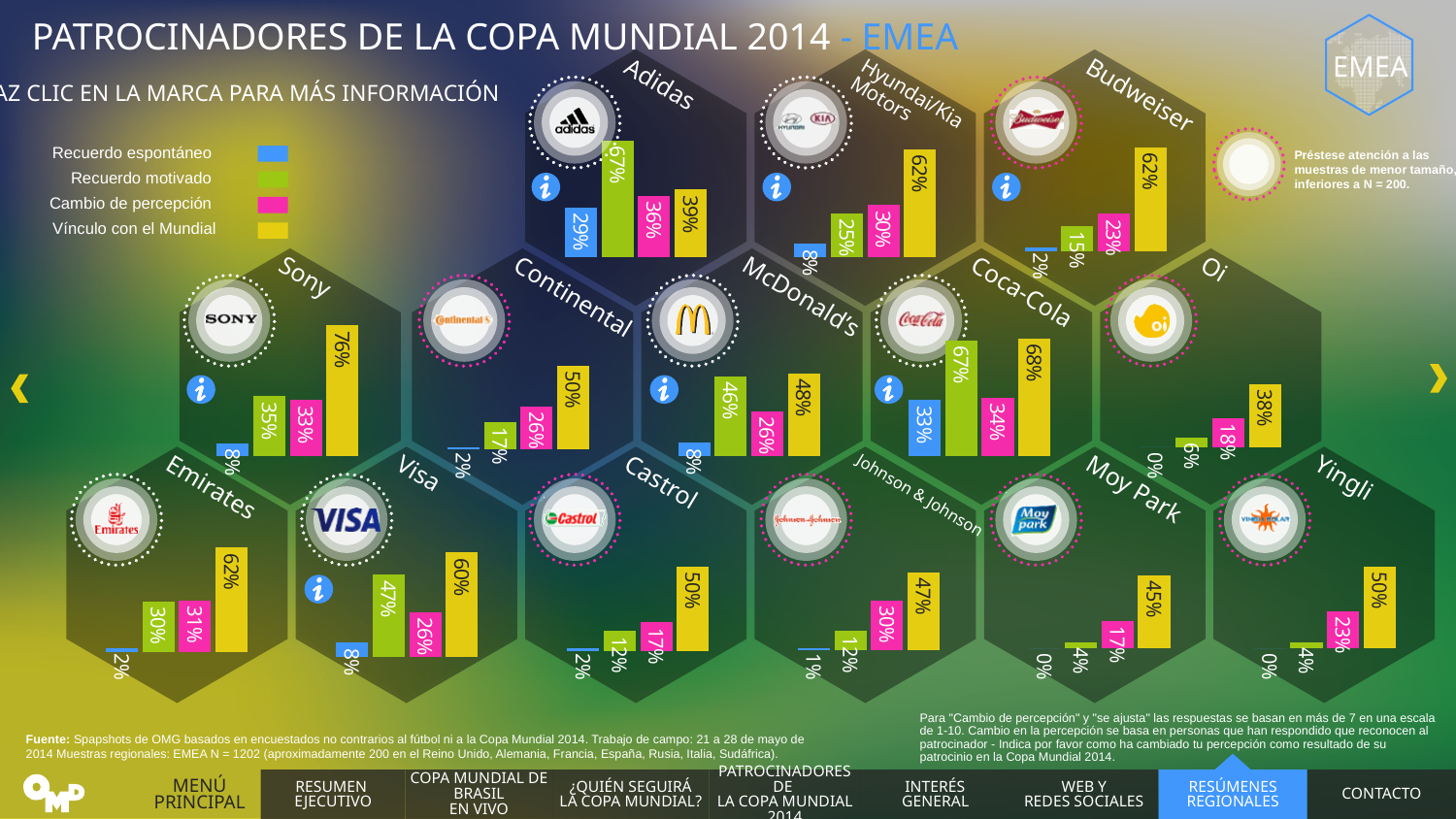
In the Budweiser chart, what is the value for Cambio de percepción? 23% In the Adidas chart, what is the value for Recuerdo motivado? 67% What kind of chart is used for each brand on the slide? Bar chart According to the legend, which colour represents Cambio de percepción? Pink How many measures does the legend list for each brand chart? 4 Across all the brand charts, which brand has the highest Vínculo con el Mundial value? Sony How many brand charts are shown on the slide? 14 In the Sony chart, what is the value for Vínculo con el Mundial? 76% In the Coca-Cola chart, what is the value for Recuerdo espontáneo? 33% In the McDonald's chart, what is the difference between Vínculo con el Mundial and Recuerdo motivado? 2% In the Oi chart, which of the four measures has the lowest value? Recuerdo espontáneo Which is larger: Recuerdo motivado for Visa or Recuerdo motivado for Castrol? Visa